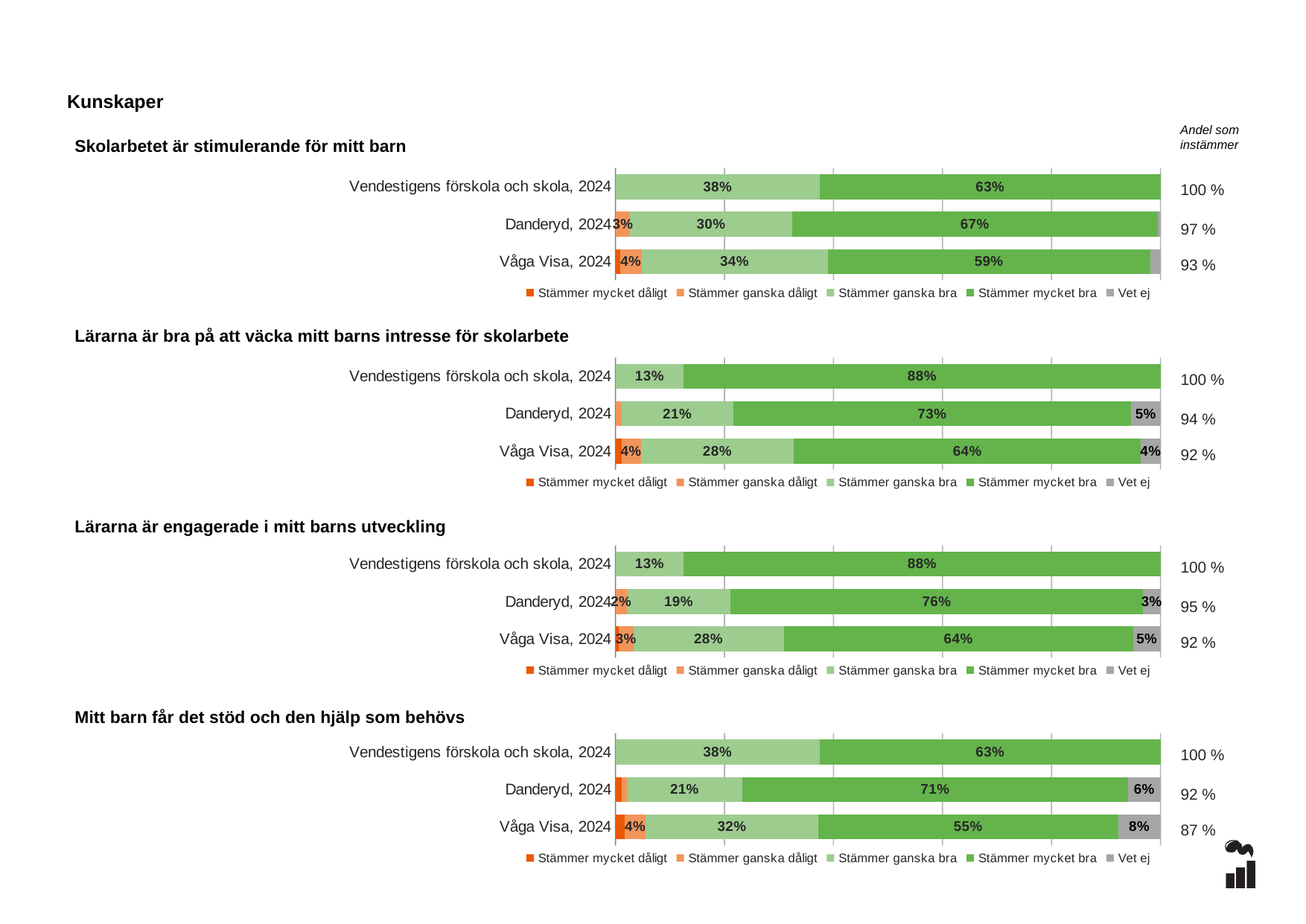
In the chart 'Lärarna är bra på att väcka mitt barns intresse för skolarbete', what is the difference between the 'Stämmer mycket bra' values for Danderyd, 2024 and Våga Visa, 2024? 9% In the chart 'Mitt barn får det stöd och den hjälp som behövs', what is the 'Stämmer mycket bra' value for Våga Visa, 2024? 55% How many series does the legend list in the chart 'Skolarbetet är stimulerande för mitt barn'? 5 In the chart 'Mitt barn får det stöd och den hjälp som behövs', which category has the lowest 'Stämmer mycket bra' value? Våga Visa, 2024 In the chart 'Lärarna är bra på att väcka mitt barns intresse för skolarbete', what is the 'Stämmer mycket bra' value for Vendestigens förskola och skola, 2024? 88% In the chart 'Lärarna är engagerade i mitt barns utveckling', which has the larger 'Stämmer ganska bra' value, Danderyd, 2024 or Våga Visa, 2024? Våga Visa, 2024 How many categories are shown in the chart 'Lärarna är engagerade i mitt barns utveckling'? 3 In the chart 'Skolarbetet är stimulerande för mitt barn', which category has the highest 'Stämmer mycket bra' value? Danderyd, 2024 In the chart 'Skolarbetet är stimulerande för mitt barn', what is the 'Stämmer mycket bra' value for Danderyd, 2024? 67% What kind of chart is 'Mitt barn får det stöd och den hjälp som behövs'? Stacked bar chart In the chart 'Mitt barn får det stöd och den hjälp som behövs', what is the 'Andel som instämmer' value for Våga Visa, 2024? 87 % In the chart 'Lärarna är engagerade i mitt barns utveckling', what is the 'Vet ej' value for Våga Visa, 2024? 5%